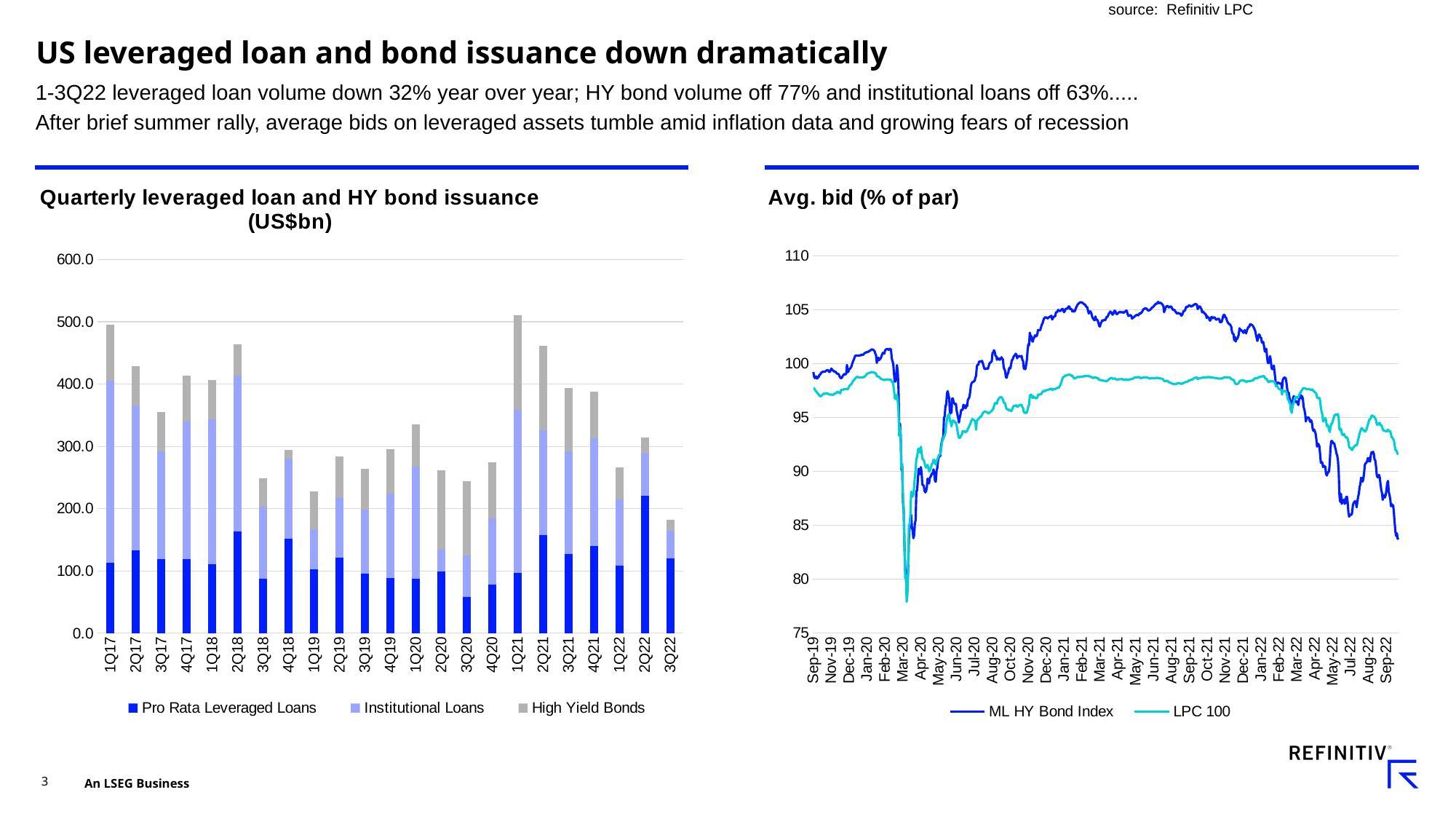
In the 'Quarterly leveraged loan and HY bond issuance (US$bn)' chart, which quarter has the lowest total issuance? 3Q22 How many quarters are shown on the x axis of the 'Quarterly leveraged loan and HY bond issuance (US$bn)' chart? 23 What kind of chart is the 'Avg. bid (% of par)' chart? Line chart In the 'Quarterly leveraged loan and HY bond issuance (US$bn)' chart, which quarter has the highest total issuance? 1Q21 How many series does the legend of the 'Quarterly leveraged loan and HY bond issuance (US$bn)' chart list? 3 In the 'Quarterly leveraged loan and HY bond issuance (US$bn)' chart, is the Pro Rata Leveraged Loans value for 2Q22 greater or less than 200? greater In the 'Avg. bid (% of par)' chart, does the ML HY Bond Index rise or fall between Jan-22 and Sep-22? Fall How many series does the legend of the 'Avg. bid (% of par)' chart list? 2 In the 'Quarterly leveraged loan and HY bond issuance (US$bn)' chart, is the total issuance for 3Q22 greater or less than 200? less What kind of chart is the 'Quarterly leveraged loan and HY bond issuance (US$bn)' chart? Stacked bar chart In the 'Quarterly leveraged loan and HY bond issuance (US$bn)' chart, is the total issuance for 1Q21 greater or less than 500? greater